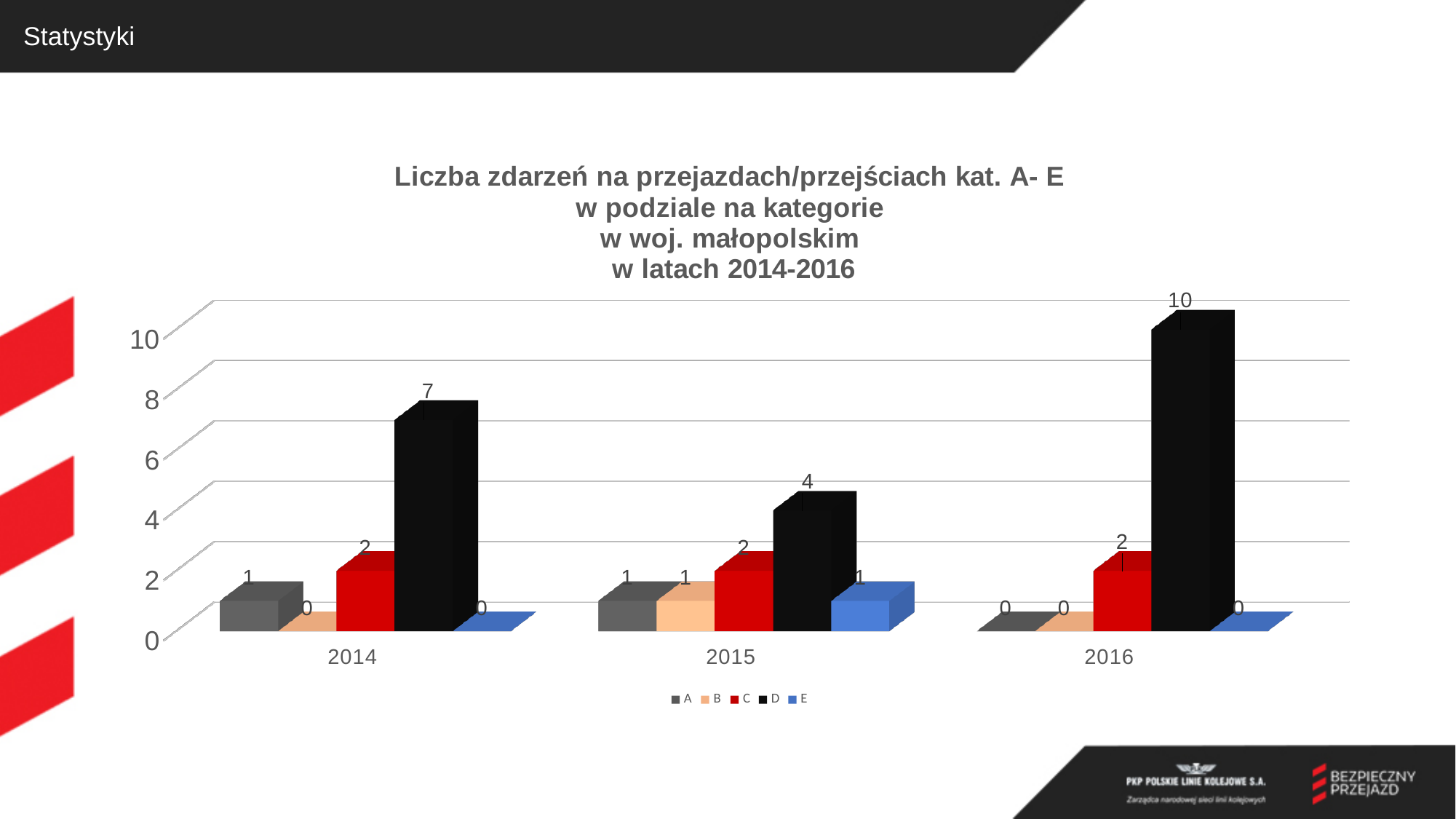
What is the value for series C in 2015? 2 What is the value for series D in 2014? 7 In which year is the value for series D highest? 2016 What is the value for series E in 2015? 1 How many years are shown on the x axis? 3 Which is larger: the value for series D in 2015 or the value for series C in 2015? D Which series is shown in red in the legend? C What is the difference between the value for series D in 2016 and in 2014? 3 What kind of chart is shown on the slide? bar chart What is the value for series D in 2016? 10 How many series does the legend list? 5 In which year is the value for series D lowest? 2015